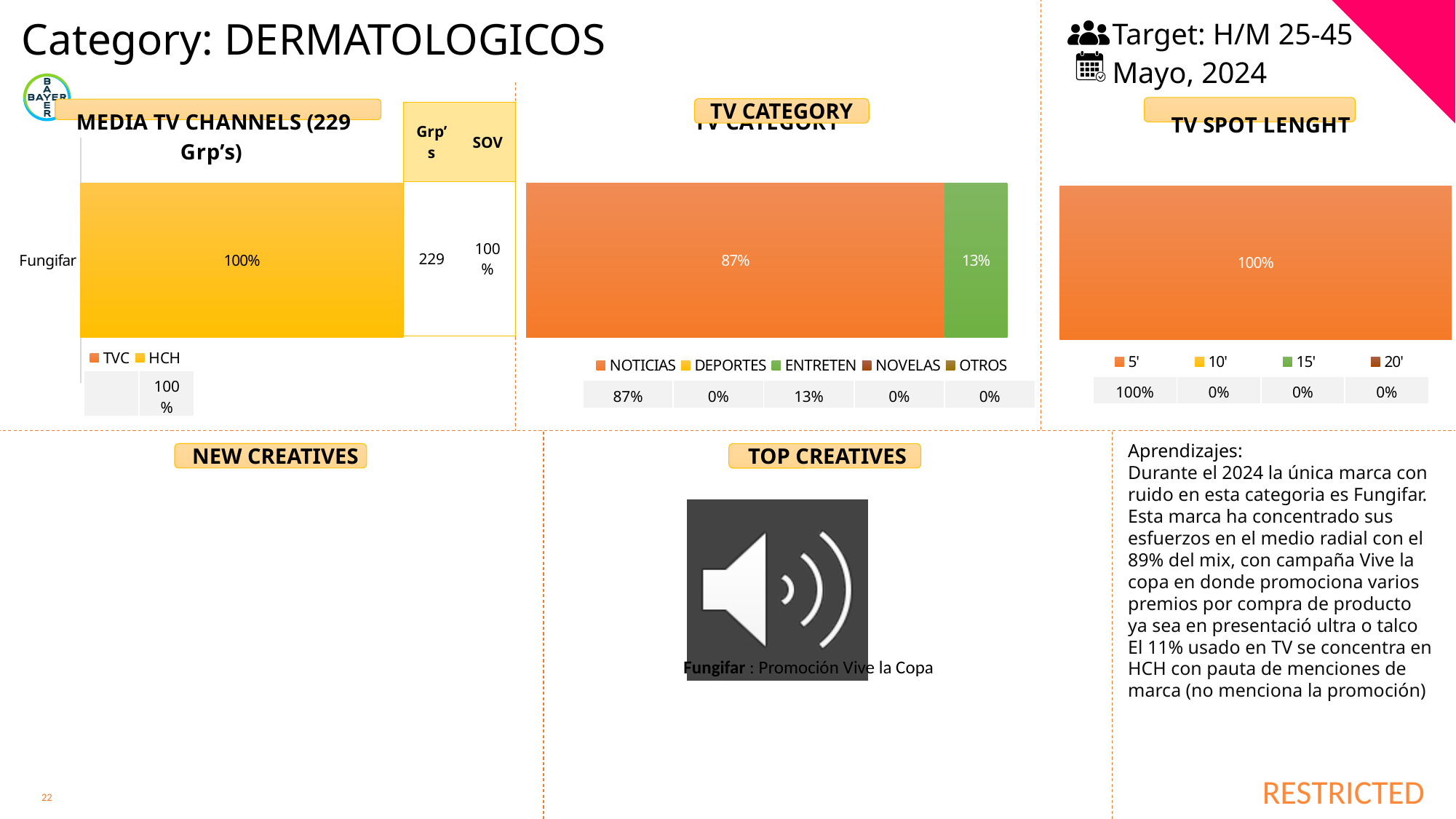
In the TV CATEGORY chart, what percentage is shown for ENTRETEN? 13% How many series does the legend of the TV CATEGORY chart list? 5 What kind of chart is the TV CATEGORY chart? Stacked bar chart In the MEDIA TV CHANNELS chart, what percentage is shown for the Fungifar bar? 100% In the TV SPOT LENGHT chart, what percentage is shown for the 5' spot length? 100% In the TV CATEGORY chart, what percentage is shown for NOTICIAS? 87% In the TV SPOT LENGHT chart, which spot length has the highest share? 5' In the TV CATEGORY chart, which category has the highest share? NOTICIAS In the MEDIA TV CHANNELS chart, what Grp's value is shown for Fungifar? 229 In the TV CATEGORY chart, what is the difference between the NOTICIAS and ENTRETEN shares? 74% In the TV CATEGORY chart, what percentage is shown for DEPORTES in the table below the legend? 0% How many series does the legend of the TV SPOT LENGHT chart list? 4